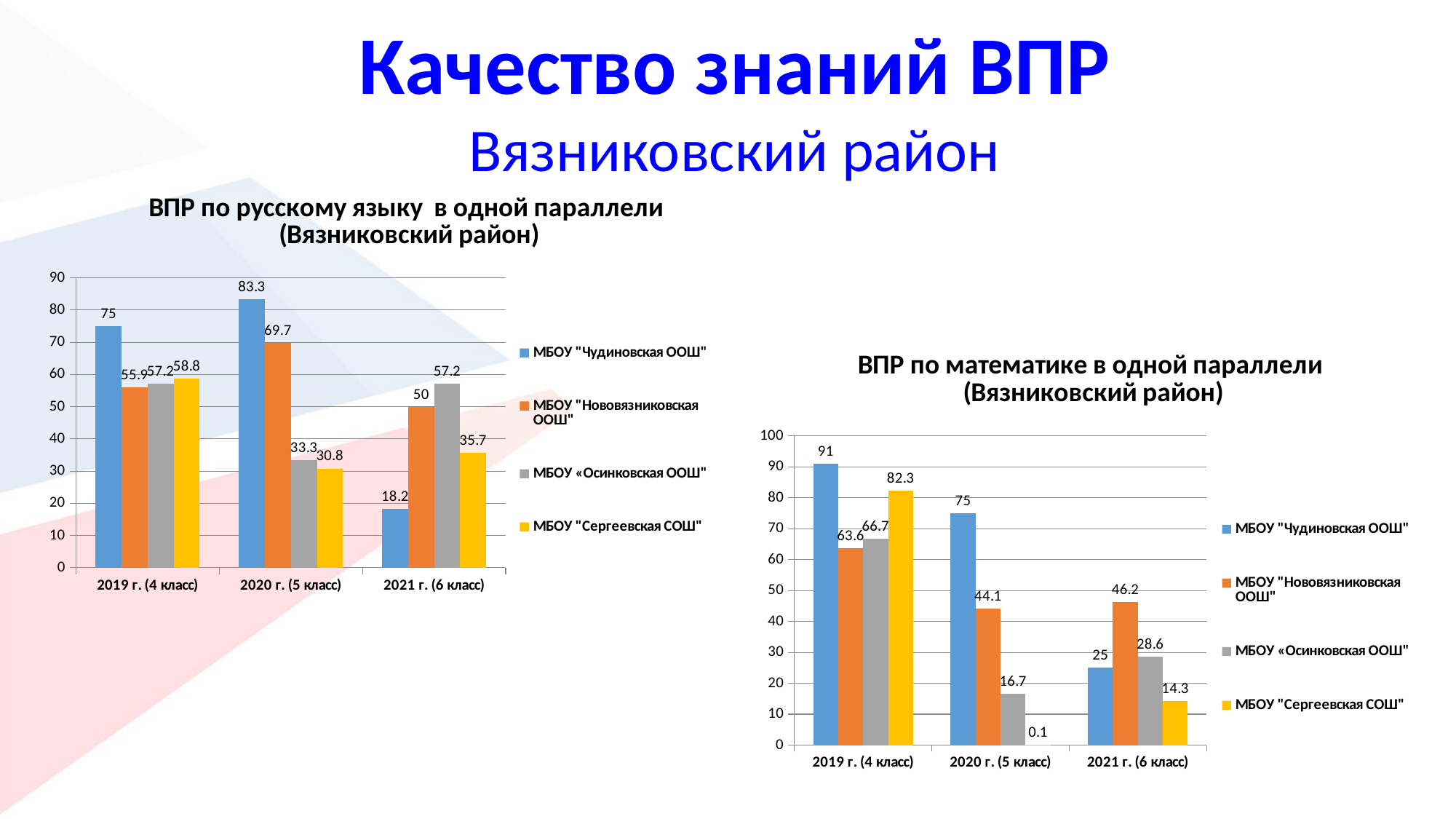
In the chart "ВПР по математике в одной параллели", how many year categories are shown on the x axis? 3 In the chart "ВПР по русскому языку в одной параллели", how does the value for МБОУ "Чудиновская ООШ" change from 2020 г. (5 класс) to 2021 г. (6 класс)? It falls In the chart "ВПР по русскому языку в одной параллели", what is the value for МБОУ "Сергеевская СОШ" in 2021 г. (6 класс)? 35.7 In the chart "ВПР по математике в одной параллели", what is the difference between МБОУ "Чудиновская ООШ" and МБОУ "Сергеевская СОШ" in 2019 г. (4 класс)? 8.7 What type of chart is "ВПР по русскому языку в одной параллели"? Bar chart In the chart "ВПР по математике в одной параллели", what is the value for МБОУ "Сергеевская СОШ" in 2020 г. (5 класс)? 0.1 In the chart "ВПР по математике в одной параллели", which is larger in 2021 г. (6 класс): МБОУ "Нововязниковская ООШ" or МБОУ «Осинковская ООШ"? МБОУ "Нововязниковская ООШ" In the chart "ВПР по математике в одной параллели", which school has the highest value in 2019 г. (4 класс)? МБОУ "Чудиновская ООШ" In the chart "ВПР по русскому языку в одной параллели", what is the difference between МБОУ "Чудиновская ООШ" and МБОУ "Нововязниковская ООШ" in 2019 г. (4 класс)? 19.1 In the chart "ВПР по русскому языку в одной параллели", what is the value for МБОУ "Чудиновская ООШ" in 2020 г. (5 класс)? 83.3 In the chart "ВПР по русскому языку в одной параллели", which school has the lowest value in 2021 г. (6 класс)? МБОУ "Чудиновская ООШ" In the chart "ВПР по математике в одной параллели", how many series does the legend list? 4